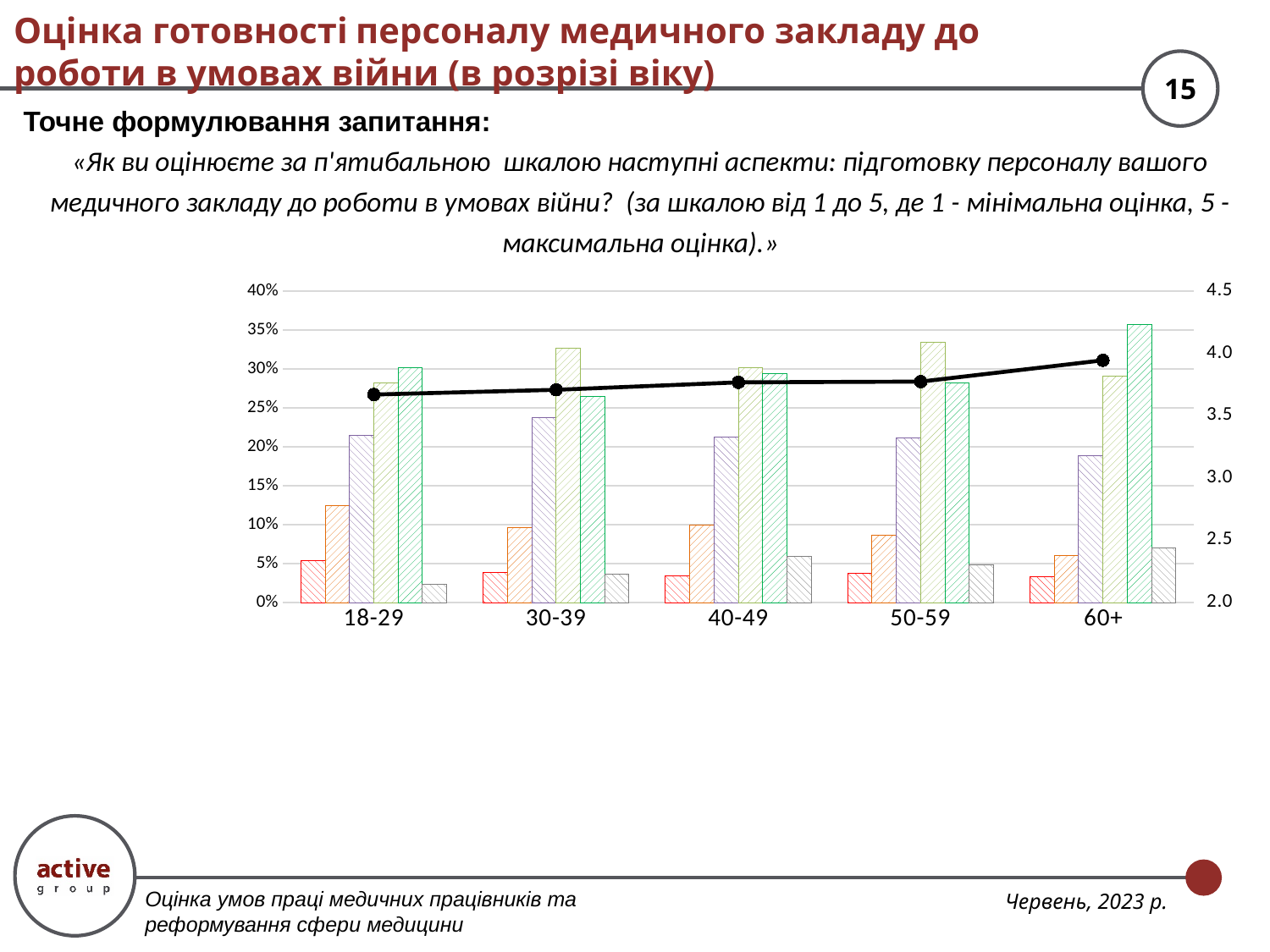
How many bars are plotted for each age group in the chart? 6 For which age group does the black line reach its highest point? 60+ What type of chart is shown on the slide? A combined bar and line chart Which age group contains the tallest bar in the whole chart? 60+ Is the tallest bar for the 60+ group greater or less than 30%? greater How many age groups are shown on the x axis of the chart? 5 Is the black line value for the 18-29 group greater or less than 4.0 on the right axis? less Is the black line value for the 60+ group greater or less than 3.5 on the right axis? greater For the 18-29 group, which is taller: the red (first) bar or the orange (second) bar? The orange (second) bar Does the black line rise or fall from the 18-29 group to the 60+ group? Rises What is the highest value shown on the left vertical axis of the chart? 40%